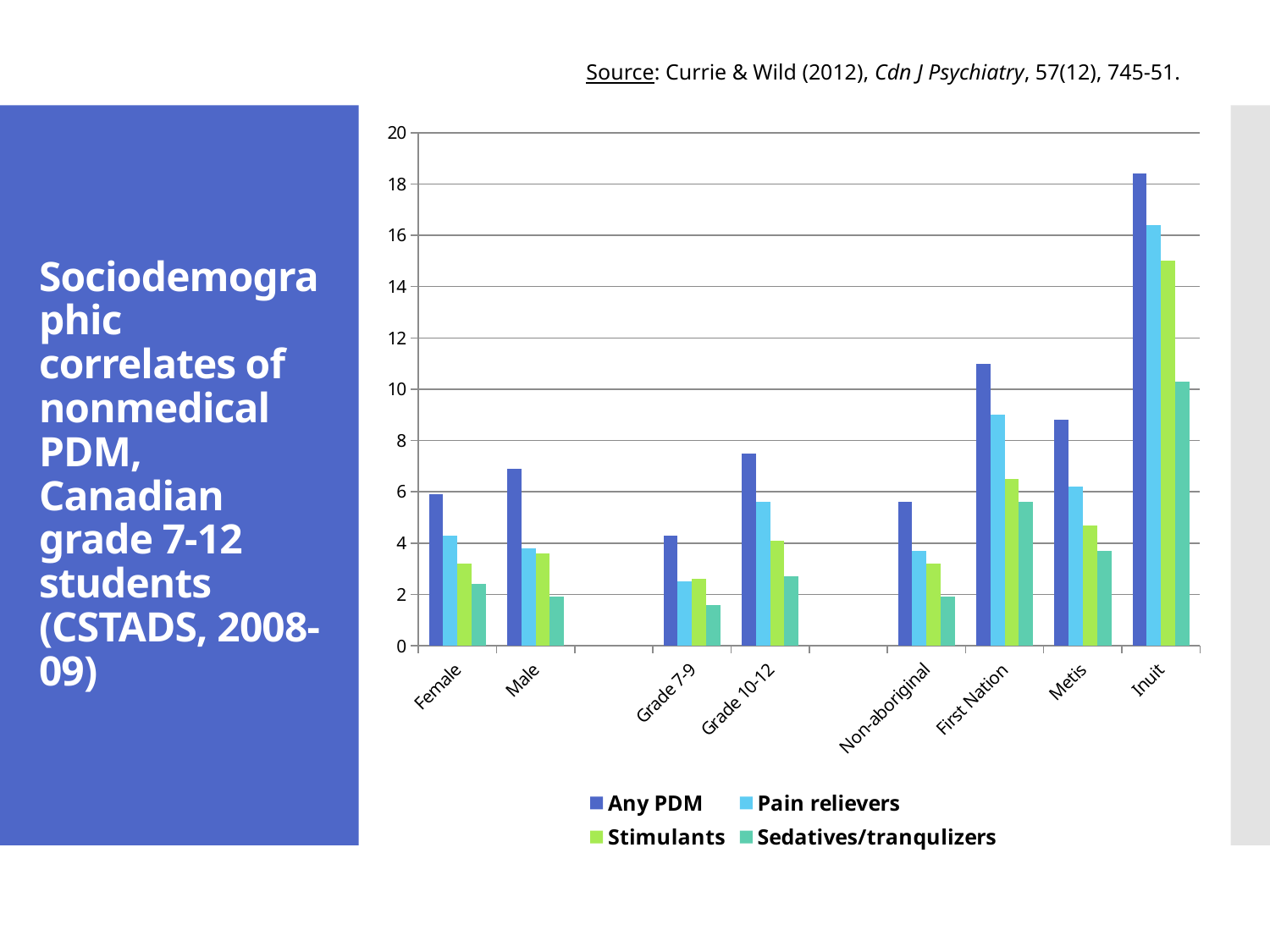
Which has the larger Any PDM value, First Nation or Metis? First Nation Is the Any PDM value for Inuit greater or less than 16? greater How many series does the legend list? 4 How many categories are shown on the x axis? 8 Is the Any PDM value for First Nation greater or less than 10? greater Is the Sedatives/tranquilizers value for Inuit greater or less than 8? greater Which category has the lowest Any PDM value? Grade 7-9 Which category has the highest Any PDM value? Inuit Which series is shown in dark blue in the legend? Any PDM Which has the larger Any PDM value, Male or Female? Male What kind of chart is shown on the slide? bar chart